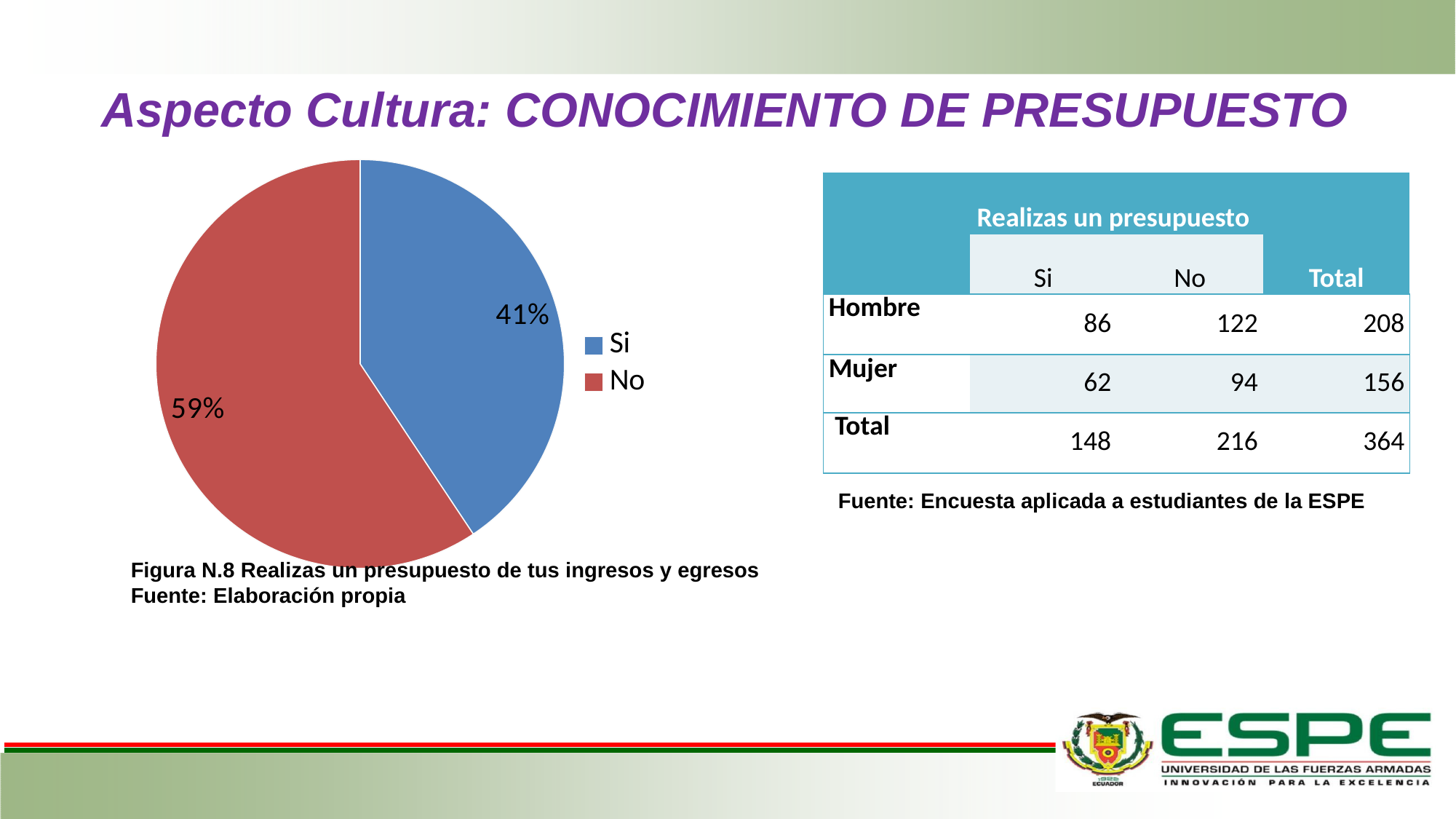
What kind of chart is shown on the slide? pie chart Which slice of the pie chart is the smallest? Si What is the difference in percentage points between the "No" slice and the "Si" slice? 18% How many entries does the legend of the pie chart list? 2 What colour is the "No" slice in the pie chart? red What is the figure caption given below the pie chart? Figura N.8 Realizas un presupuesto de tus ingresos y egresos What share of the pie does the "Si" slice represent? 41% What share of the pie does the "No" slice represent? 59% Which is larger in the pie chart, the "Si" slice or the "No" slice? No Is the share of the "Si" slice greater or less than 50%? less Which slice of the pie chart is the largest? No How many slices does the pie chart have? 2